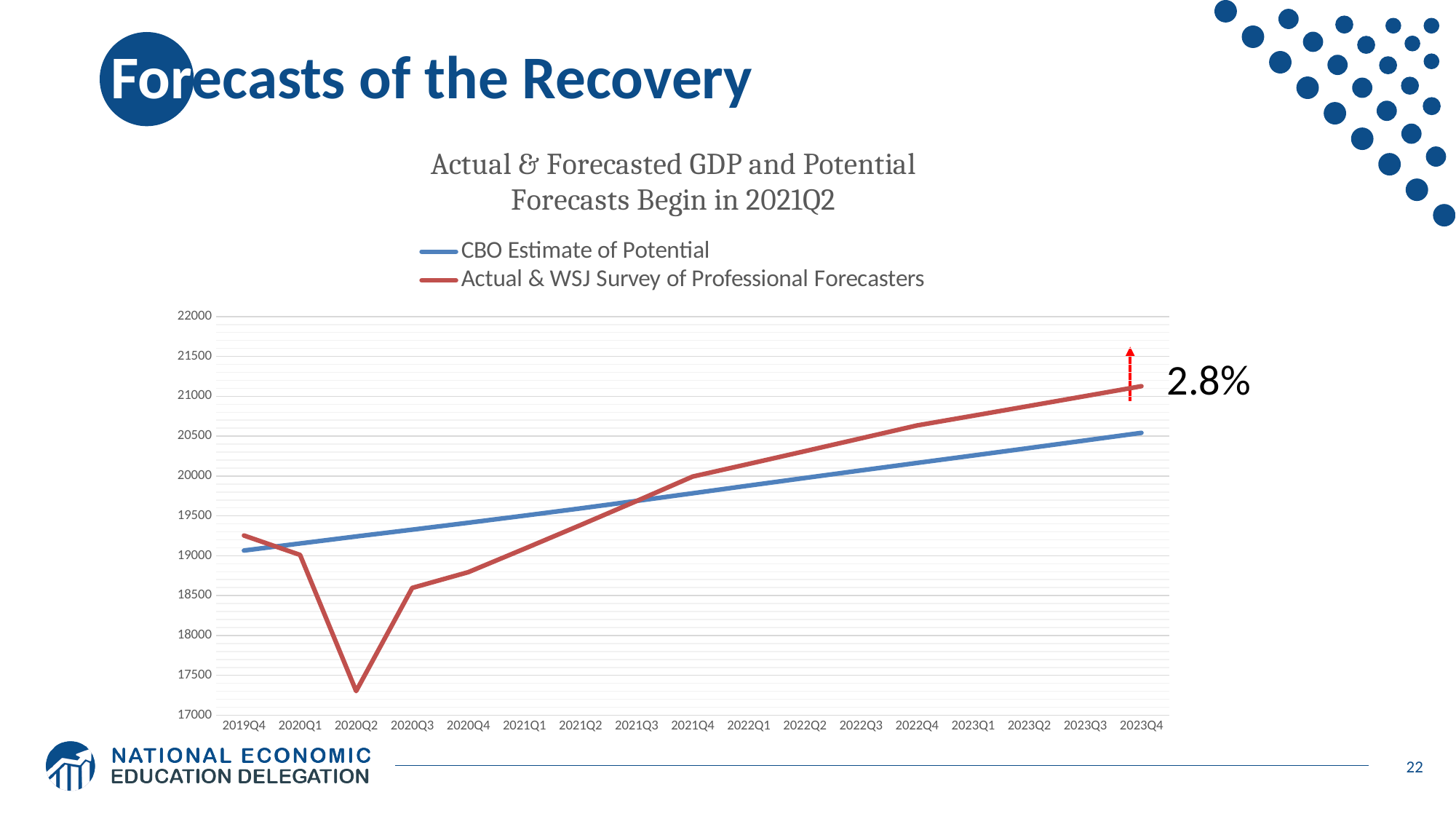
What kind of chart is shown on the slide? line chart How many series does the legend list? 2 At 2020Q2, which series is higher: CBO Estimate of Potential or Actual & WSJ Survey of Professional Forecasters? CBO Estimate of Potential Does the CBO Estimate of Potential line rise or fall from 2019Q4 to 2023Q4? rise How many quarters are shown along the x axis? 17 What percentage is annotated next to the end of the red line at 2023Q4? 2.8% Is the value of the Actual & WSJ Survey of Professional Forecasters line at 2020Q2 greater or less than 17500? less Is the value of the CBO Estimate of Potential line at 2023Q4 greater or less than 20000? greater Is the value of the Actual & WSJ Survey of Professional Forecasters line at 2023Q4 greater or less than 20500? greater What is the title of the chart? Actual & Forecasted GDP and Potential Forecasts Begin in 2021Q2 At 2023Q4, which series is higher: CBO Estimate of Potential or Actual & WSJ Survey of Professional Forecasters? Actual & WSJ Survey of Professional Forecasters In which quarter does the Actual & WSJ Survey of Professional Forecasters line reach its lowest point? 2020Q2